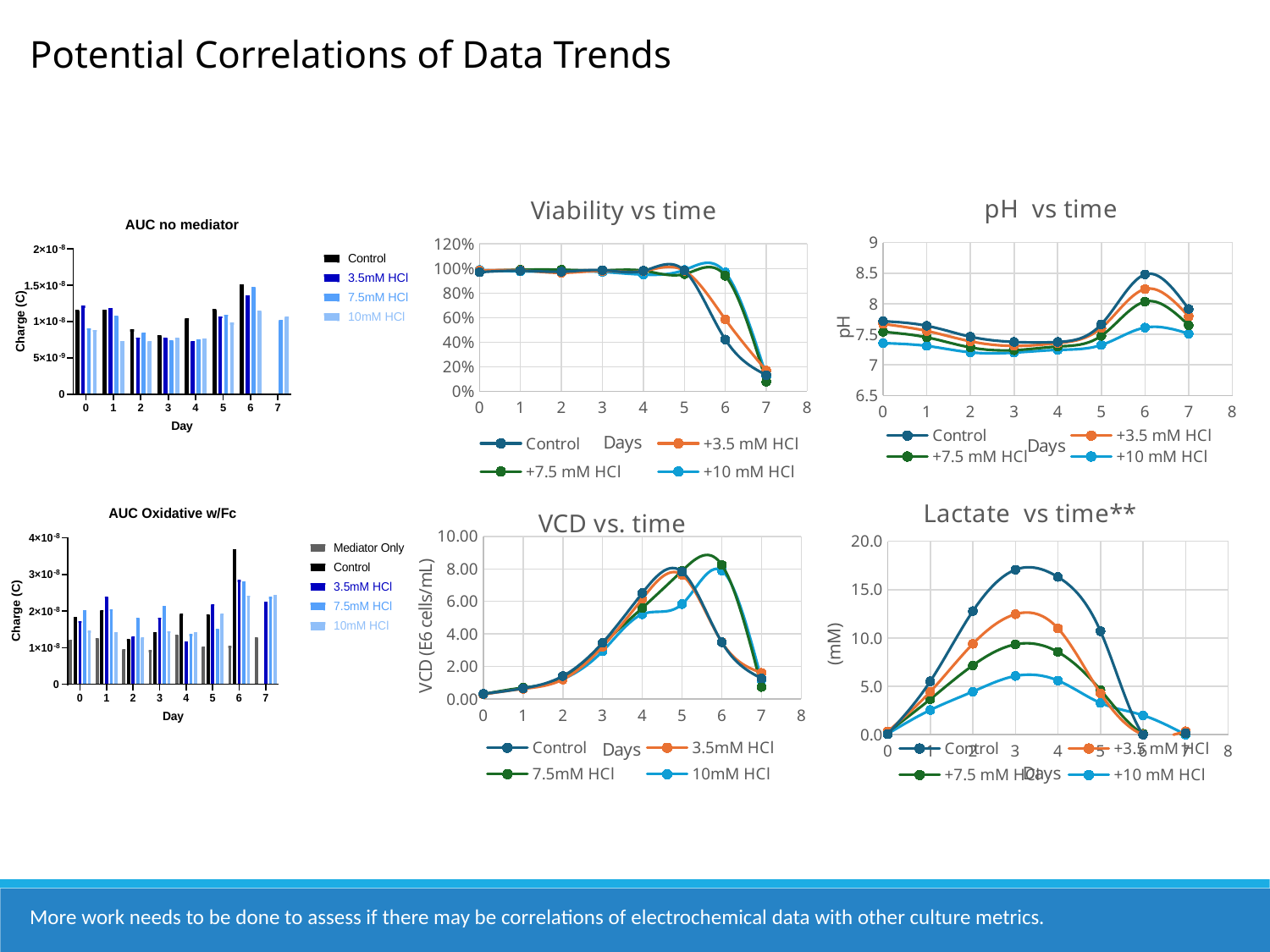
In the Lactate vs time** chart, which series reaches the highest lactate value? Control What kind of chart is the VCD vs. time chart? line chart In the Viability vs time chart, is the Control value at day 6 greater or less than 60%? less In the Lactate vs time** chart, which series has the lowest value at day 3? +10 mM HCl In the Viability vs time chart, how many series does the legend list? 4 In the pH vs time chart, is the +10 mM HCl value at day 6 greater or less than 8? less In the AUC no mediator chart, how many series does the legend list? 4 In the AUC Oxidative w/Fc chart, on which day is the Control bar highest? Day 6 In the Lactate vs time** chart, is the Control value at day 3 greater or less than 15.0? greater In the Viability vs time chart, does the Control series rise or fall from day 5 to day 7? fall In the AUC Oxidative w/Fc chart, how many series does the legend list? 5 In the pH vs time chart, which series has the highest pH at day 6? Control